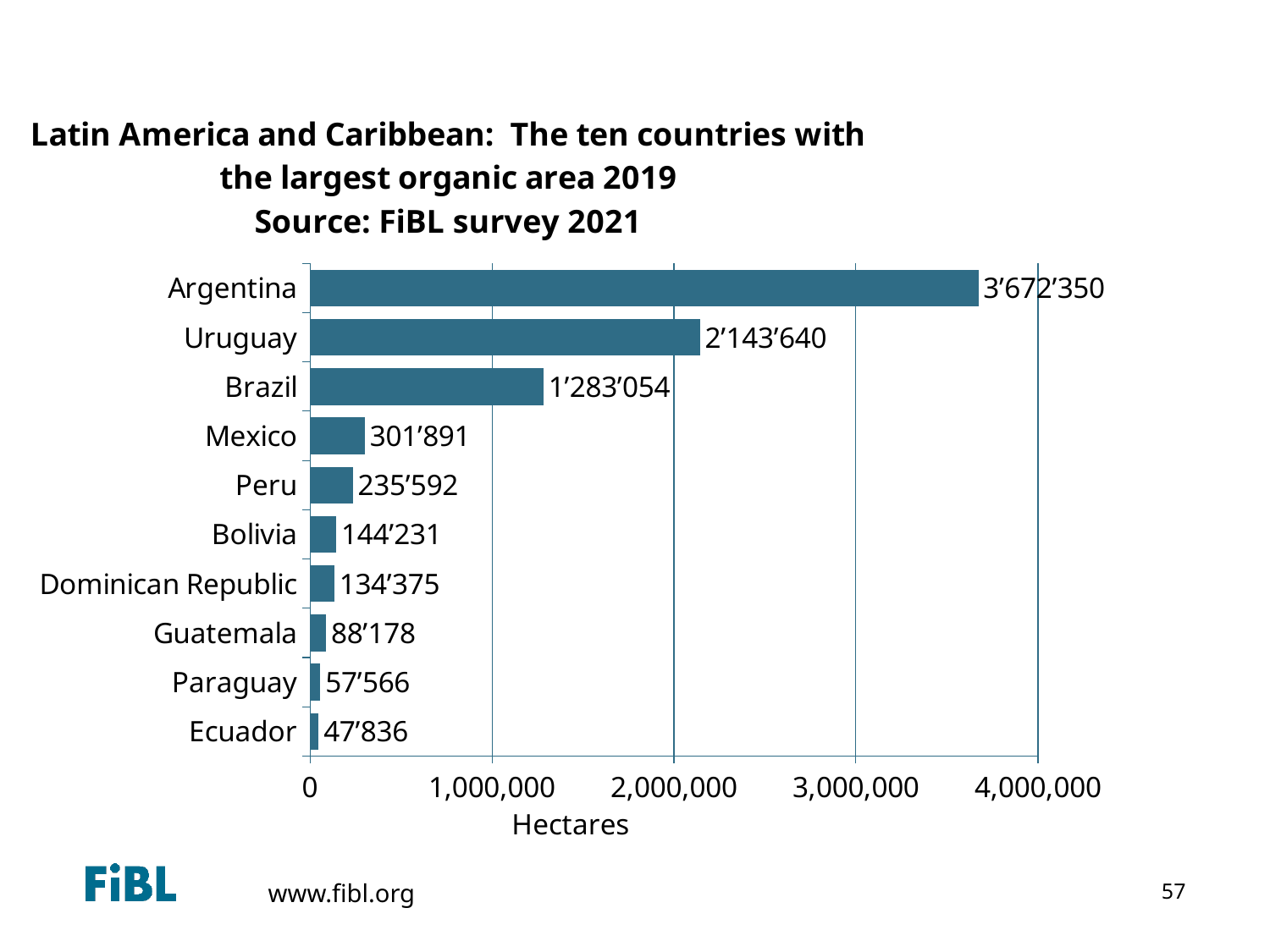
Which country has the largest organic area? Argentina What is the organic area for the Dominican Republic? 134’375 What is the organic area for Argentina? 3’672’350 Is the value for Brazil greater or less than 1,000,000? greater Which country has the smallest organic area? Ecuador What is the organic area for Brazil? 1’283’054 Which has a larger organic area, Guatemala or Paraguay? Guatemala What is the difference between the organic area of Mexico and Peru? 66’299 What unit is shown on the horizontal axis of the chart? Hectares What is the difference between the organic area of Argentina and Uruguay? 1’528’710 What kind of chart is shown on the slide? bar chart How many countries are shown in the chart? 10